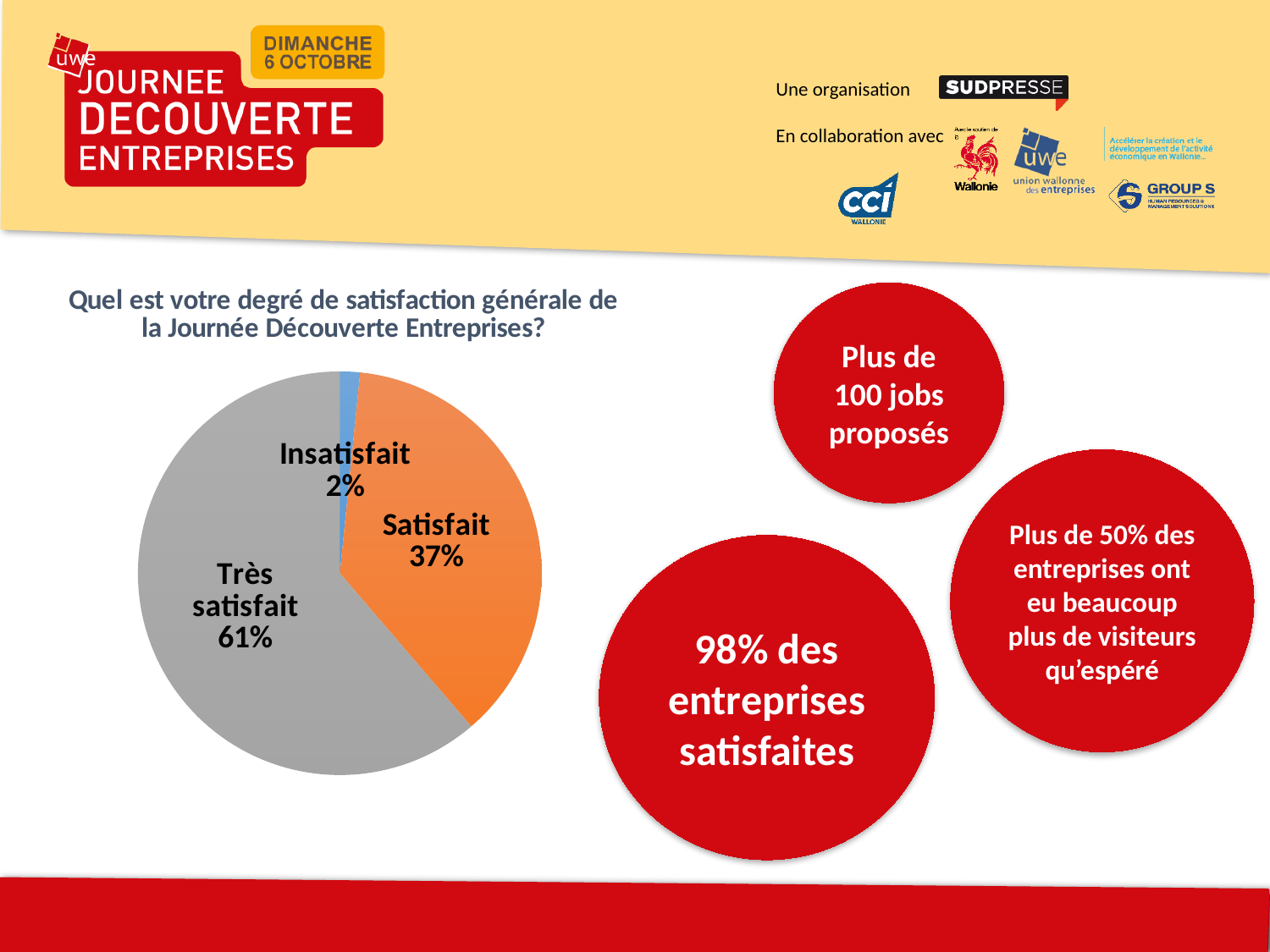
What is the combined share of "Très satisfait" and "Satisfait"? 98% What colour is the "Très satisfait" slice of the pie? grey What is the difference in percentage points between "Très satisfait" and "Satisfait"? 24 What share of the pie is labelled "Très satisfait"? 61% What type of chart is shown on the slide? pie chart What share of the pie is labelled "Insatisfait"? 2% How many slices does the pie chart have? 3 Which category has the smallest slice of the pie? Insatisfait Which is larger, the "Satisfait" slice or the "Insatisfait" slice? Satisfait What share of the pie is labelled "Satisfait"? 37% Which category has the largest slice of the pie? Très satisfait What question is the pie chart titled with? Quel est votre degré de satisfaction générale de la Journée Découverte Entreprises?